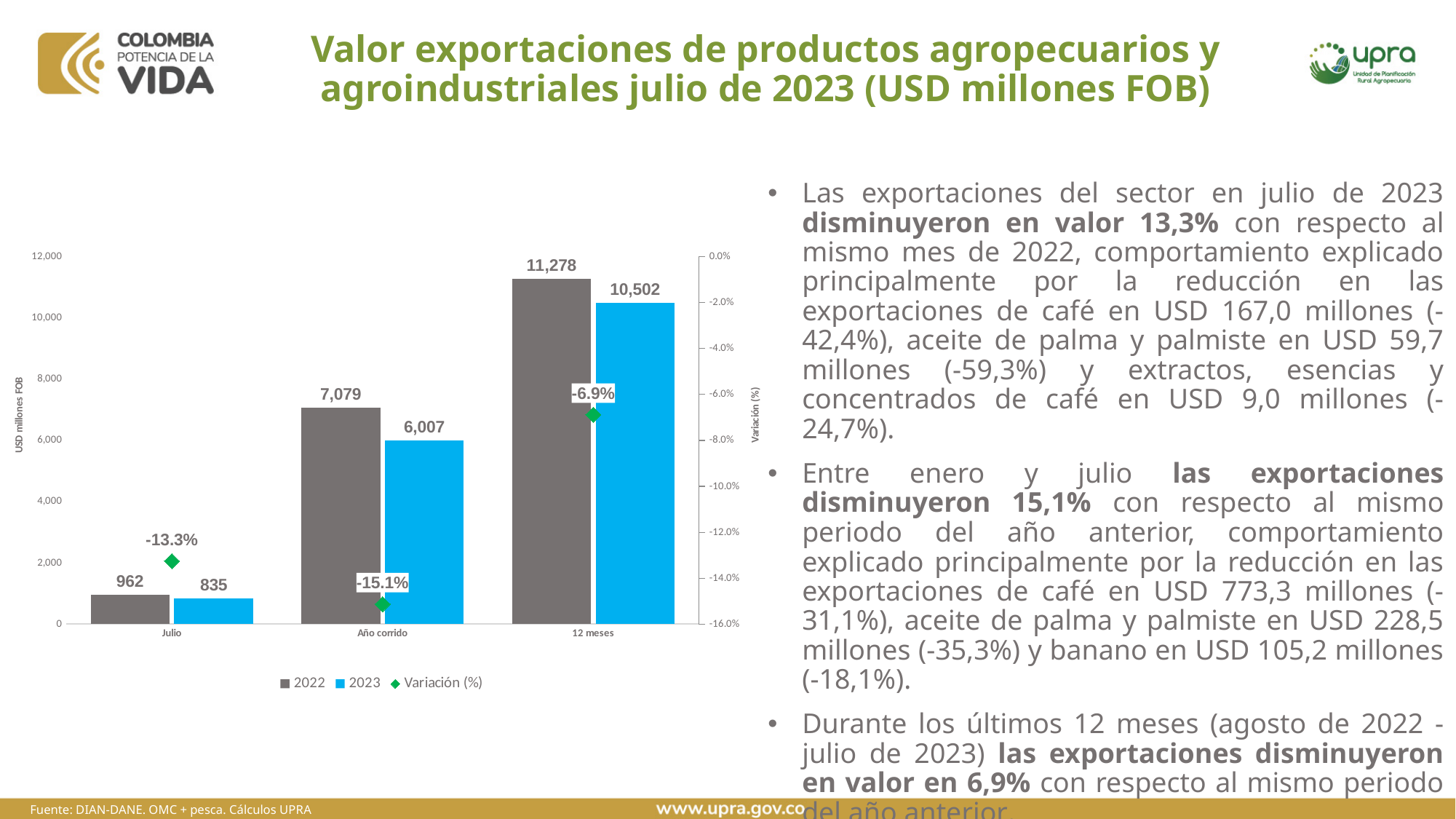
Which category has the highest 2023 value? 12 meses What is the 2022 value for 12 meses? 11,278 What is the 2022 value for Julio? 962 What is the difference between the 2022 and 2023 values for Año corrido? 1,072 Which category has the lowest 2022 value? Julio What is the label of the left vertical axis? USD millones FOB What kind of chart is shown on the slide? Bar chart with a line/marker series Which is larger for 12 meses, the 2022 value or the 2023 value? 2022 What is the Variación (%) for 12 meses? -6.9% How many series does the legend list? 3 How many categories are shown on the x axis? 3 What is the 2023 value for Año corrido? 6,007